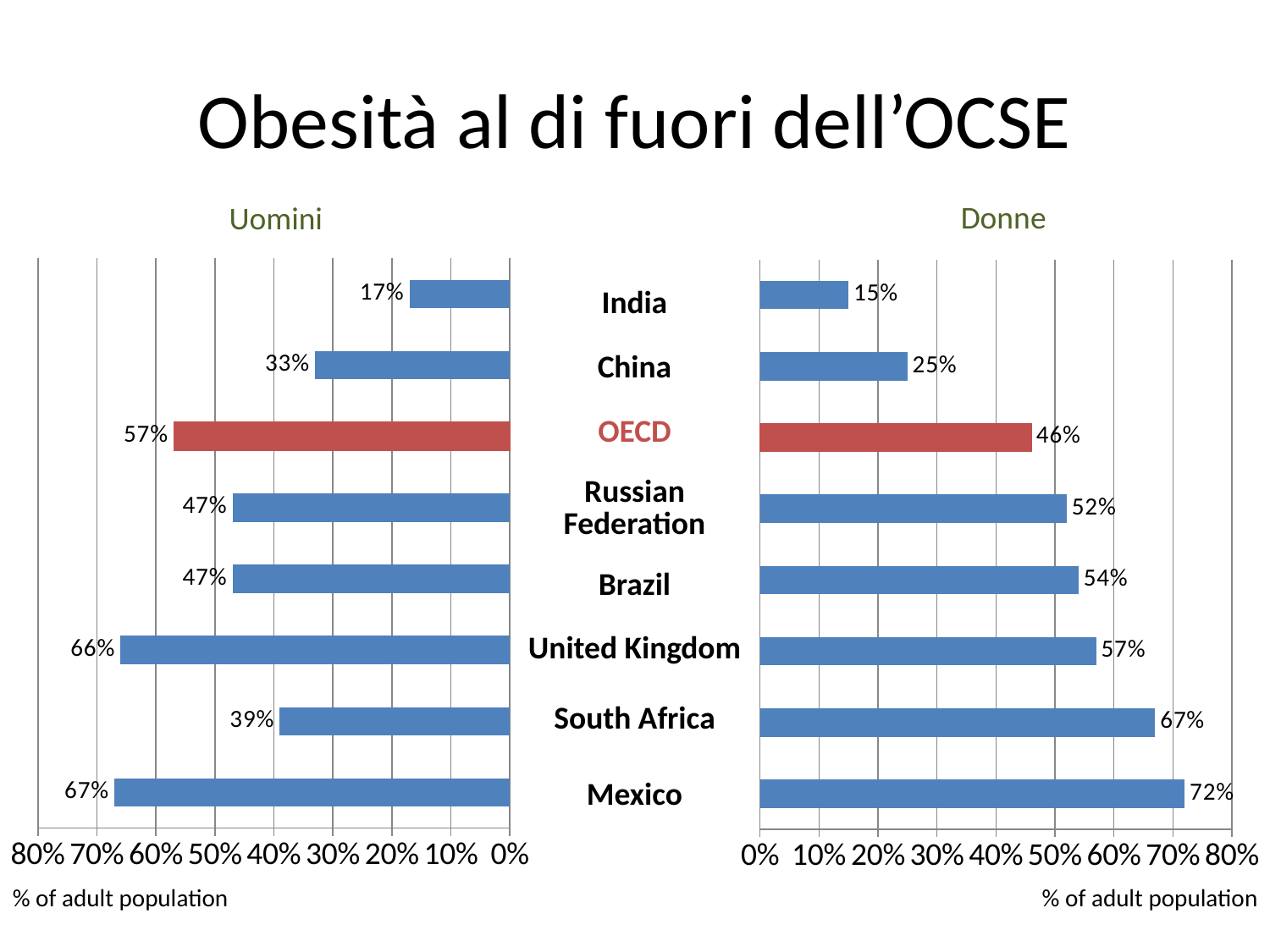
Which category's bar is coloured red in both charts? OECD In the Donne chart, what is the value for South Africa? 67% In the Uomini chart, which category has the lowest value? India In the Donne chart, what is the value for OECD? 46% In the Uomini chart, which is larger, the value for China or the value for Brazil? Brazil In the Uomini chart, what is the difference between the values for United Kingdom and South Africa? 27% How many categories are shown in the Donne chart? 8 What kind of chart is the Uomini chart? bar chart In the Donne chart, what is the difference between the values for Mexico and India? 57% In the Uomini chart, what is the value for Mexico? 67% In the Donne chart, which category has the highest value? Mexico In the Donne chart, is the value for Russian Federation greater or less than 50%? greater